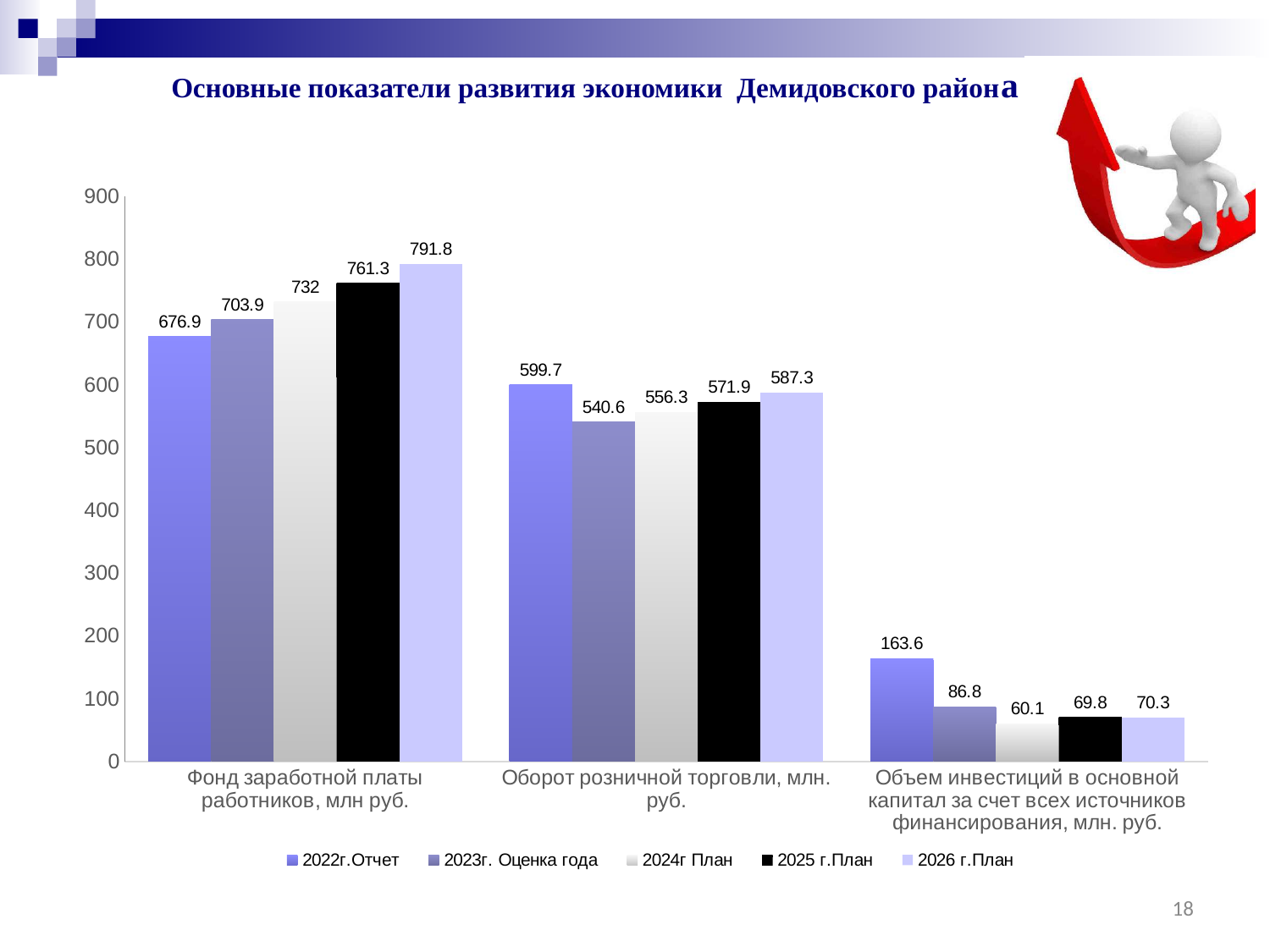
Which is larger in the category "Оборот розничной торговли, млн. руб.": the 2022г.Отчет value or the 2025 г.План value? 2022г.Отчет Which series has the highest value in the category "Фонд заработной платы работников, млн руб."? 2026 г.План What is the difference between the 2022г.Отчет and 2023г. Оценка года values in the category "Объем инвестиций в основной капитал за счет всех источников финансирования, млн. руб."? 76.8 What is the value for 2024г План in the category "Объем инвестиций в основной капитал за счет всех источников финансирования, млн. руб."? 60.1 How many categories are shown on the x axis of the chart? 3 How many series does the legend list? 5 What kind of chart is shown on the slide? Bar chart What is the difference between the 2026 г.План and 2022г.Отчет values in the category "Фонд заработной платы работников, млн руб."? 114.9 Do the values for "Фонд заработной платы работников, млн руб." rise or fall from 2022г.Отчет to 2026 г.План? Rise What is the value for 2026 г.План in the category "Оборот розничной торговли, млн. руб."? 587.3 Which series has the lowest value in the category "Оборот розничной торговли, млн. руб."? 2023г. Оценка года What is the value for 2022г.Отчет in the category "Фонд заработной платы работников, млн руб."? 676.9